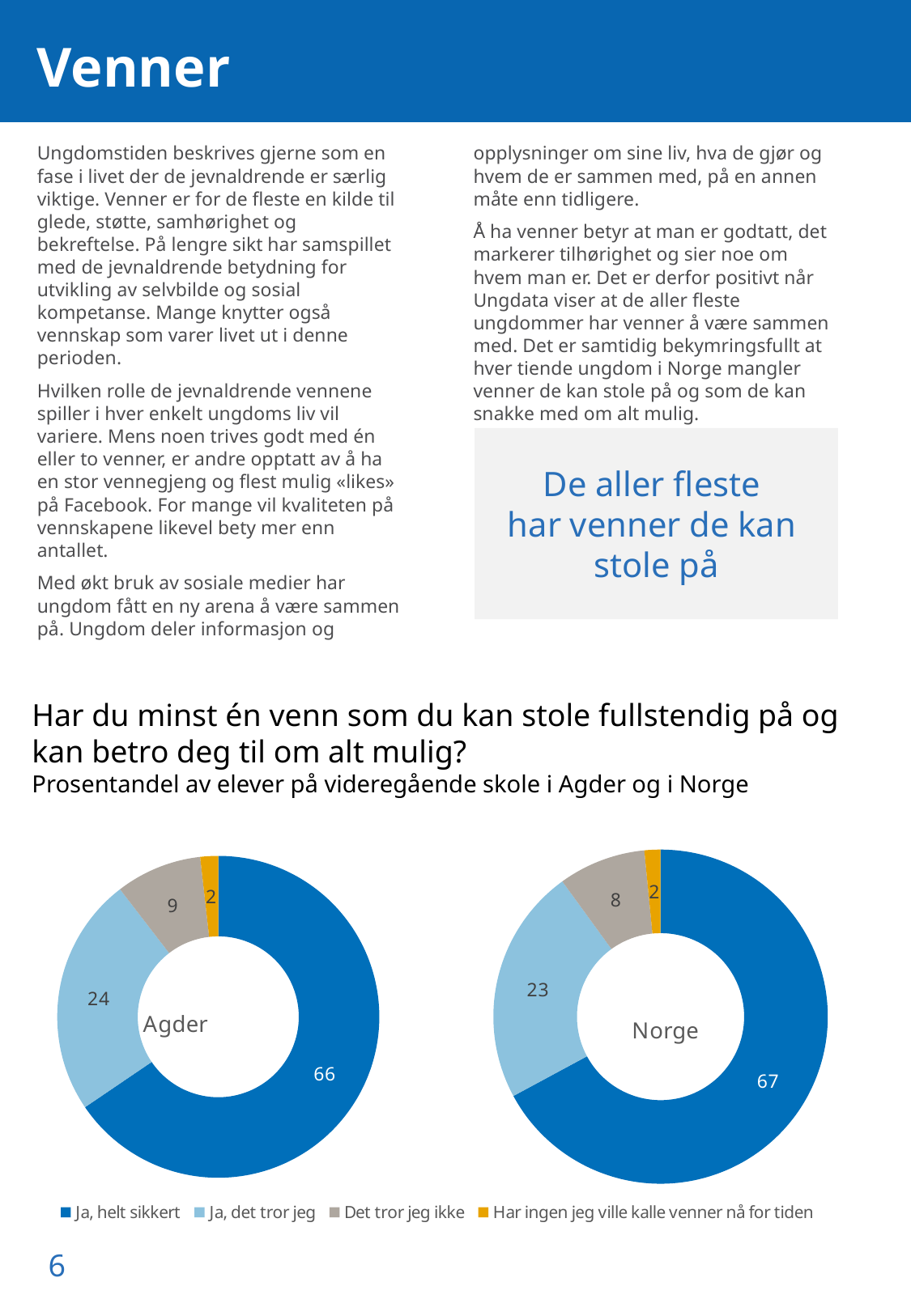
In the Norge chart, what is the value for "Har ingen jeg ville kalle venner nå for tiden"? 2 In the Norge chart, which category has the smallest share? Har ingen jeg ville kalle venner nå for tiden Is the "Ja, helt sikkert" value larger in the Agder chart or the Norge chart? Norge Which colour represents "Det tror jeg ikke" in the legend? Grey In the Agder chart, what is the difference between "Ja, helt sikkert" and "Ja, det tror jeg"? 42 In the Agder chart, what is the value for "Ja, helt sikkert"? 66 What type of chart is used for Agder and Norge? Donut (pie) chart In the Agder chart, what is the value for "Det tror jeg ikke"? 9 In the Agder chart, which category has the largest share? Ja, helt sikkert In the Norge chart, what is the value for "Ja, det tror jeg"? 23 How many categories does each donut chart show? 4 What is the difference between the "Ja, det tror jeg" values in the Agder chart and the Norge chart? 1